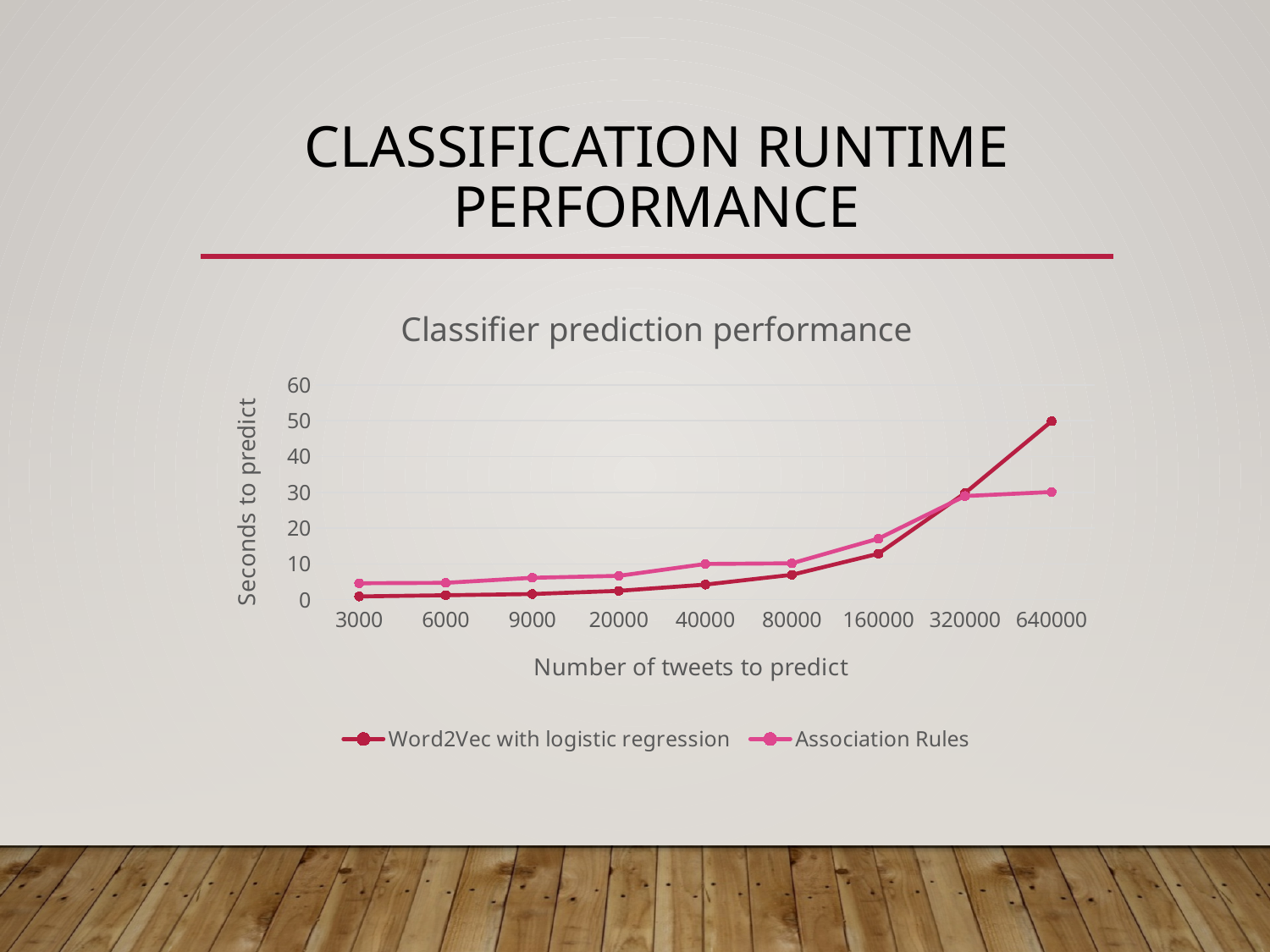
How many series does the legend list? 2 What is the title of the chart? Classifier prediction performance What is the label of the y axis? Seconds to predict Which series has the higher value at 640000 tweets? Word2Vec with logistic regression Which series has the higher value at 40000 tweets? Association Rules Do the values for Word2Vec with logistic regression rise or fall as the number of tweets increases? rise Is the value for Word2Vec with logistic regression at 3000 tweets greater or less than 10? less Is the value for Word2Vec with logistic regression at 640000 tweets greater or less than 40? greater How many points are plotted along the x axis for each series? 9 Is the value for Association Rules at 640000 tweets greater or less than 40? less What type of chart is shown on the slide? line chart